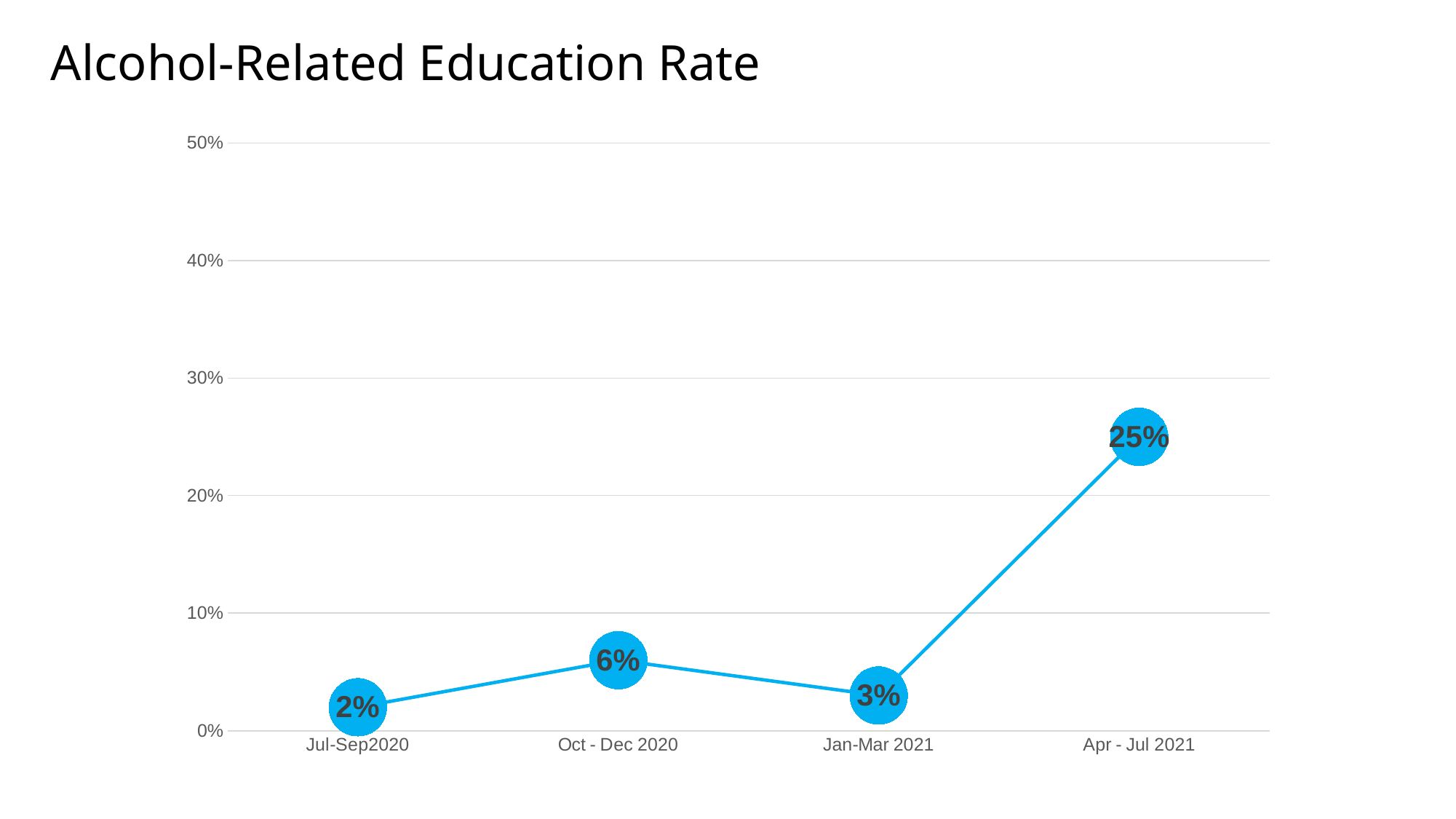
Which period has the lowest value? Jul-Sep2020 What kind of chart is shown on the slide? line chart Which is larger, the value for Oct - Dec 2020 or the value for Jan-Mar 2021? Oct - Dec 2020 What is the value for Oct - Dec 2020? 6% What is the value for Jan-Mar 2021? 3% What is the difference between the values for Apr - Jul 2021 and Jan-Mar 2021? 22% What is the value for Apr - Jul 2021? 25% What is the title of the chart? Alcohol-Related Education Rate Is the value for Apr - Jul 2021 greater or less than 20%? greater Which period has the highest value? Apr - Jul 2021 How many periods are plotted on the chart? 4 What is the value for Jul-Sep2020? 2%